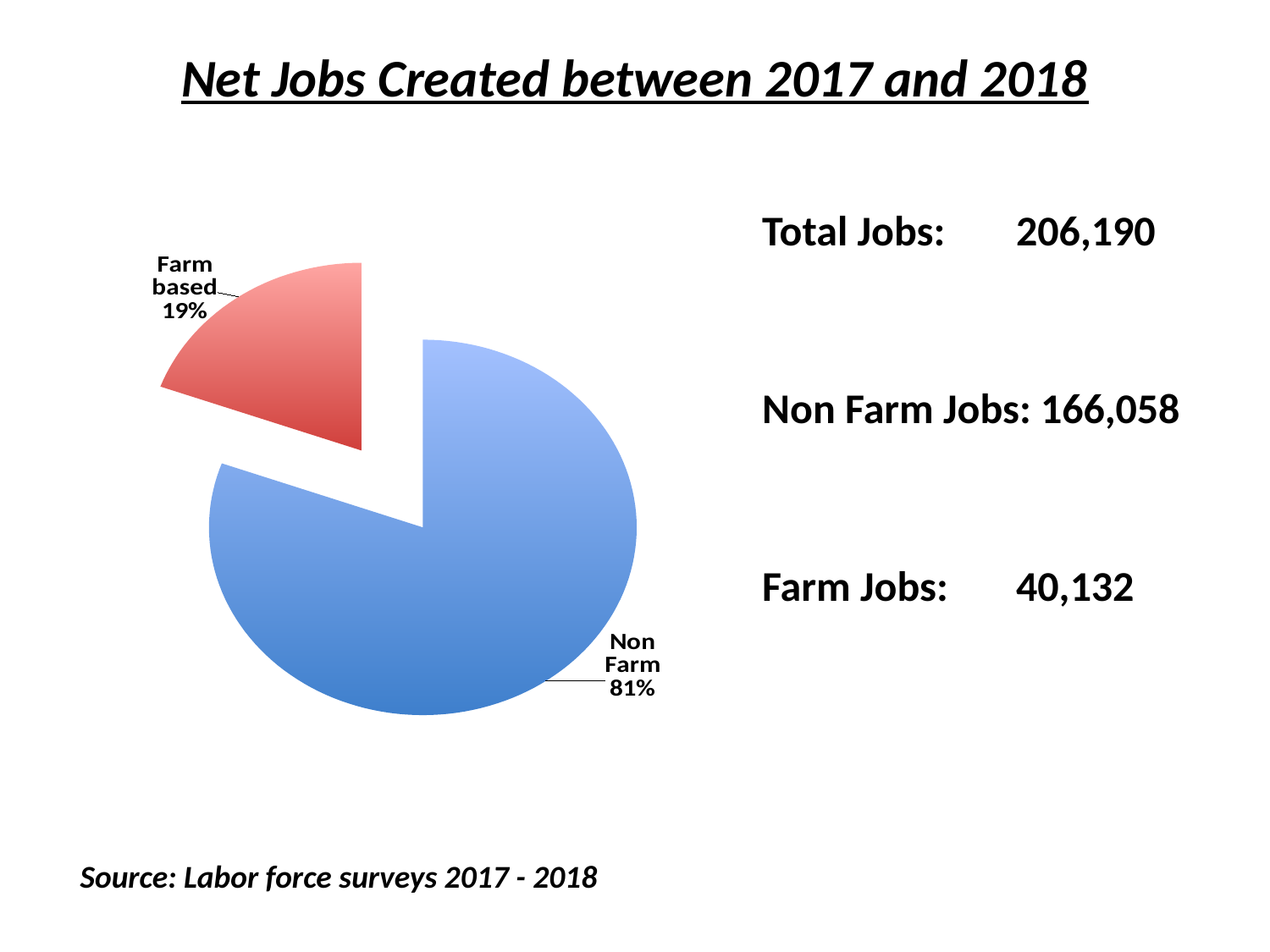
What share of the pie does the Farm based slice represent? 19% How many slices does the pie chart have? 2 Which slice of the pie is the smallest? Farm based What colour is the Farm based slice of the pie? Red What share of the pie does the Non Farm slice represent? 81% Which slice of the pie is the largest? Non Farm Which is larger, the Non Farm slice or the Farm based slice? Non Farm What kind of chart is shown on the slide? Pie chart What is the difference in percentage points between the Non Farm share and the Farm based share? 62 percentage points Is the Non Farm share greater or less than 50%? greater What is the title of the chart on the slide? Net Jobs Created between 2017 and 2018